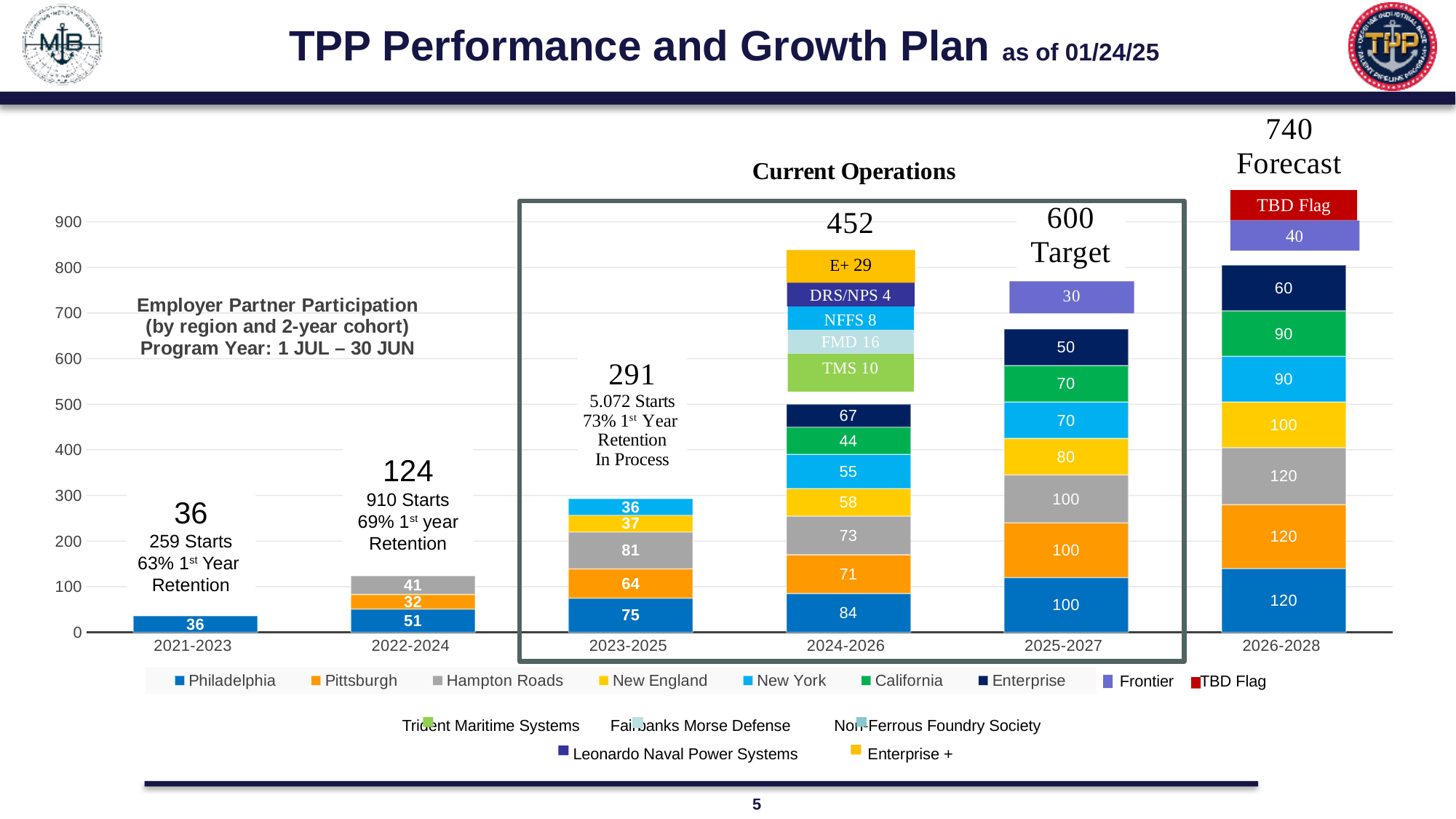
In the 2024-2026 cohort, which is larger: Pittsburgh or Hampton Roads? Hampton Roads What is the total target for the 2025-2027 cohort? 600 How many cohorts are shown on the x axis? 6 Do the cohort totals rise or fall from 2021-2023 to 2026-2028? Rise Which cohort has the lowest total? 2021-2023 What kind of chart is shown on the slide? Stacked bar chart What is the E+ value shown in the 2024-2026 cohort? 29 Which cohort has the highest total? 2026-2028 What is the Hampton Roads value for the 2023-2025 cohort? 81 What is the Philadelphia value for the 2024-2026 cohort? 84 How much larger is the Philadelphia value in 2023-2025 than in 2022-2024? 24 What is the Enterprise value for the 2025-2027 cohort? 50